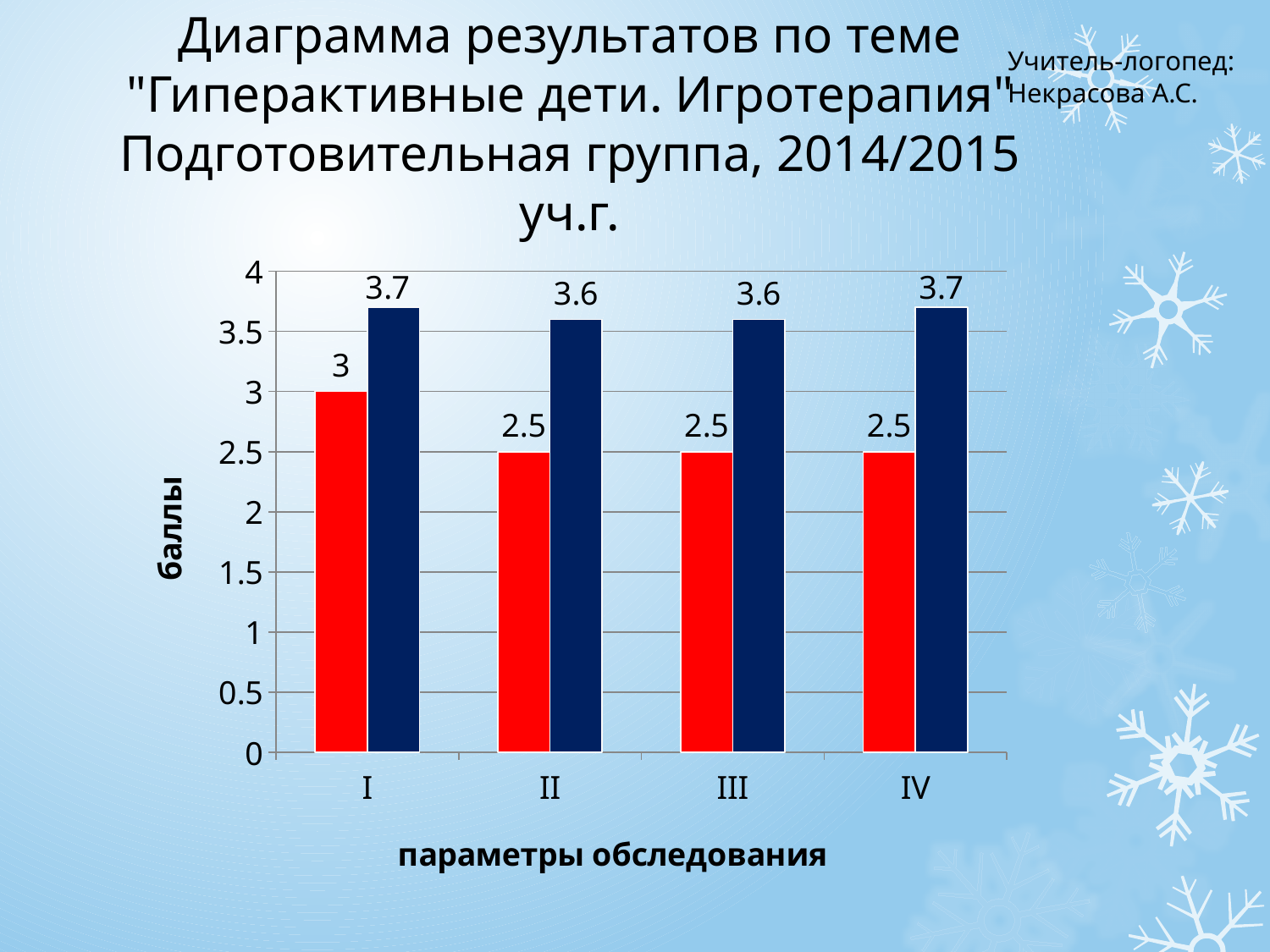
What is the difference between the dark blue bar and the red bar for category I? 0.7 What is the value of the red bar for category IV? 2.5 What is the label of the y axis of the chart? баллы Which category has the highest red bar? I What is the value of the red bar for category I? 3 What is the difference between the dark blue bar and the red bar for category III? 1.1 What is the value of the dark blue bar for category IV? 3.7 For category II, which bar is larger, the red one or the dark blue one? the dark blue one What type of chart is shown on the slide? bar chart What is the label of the x axis of the chart? параметры обследования What is the value of the dark blue bar for category II? 3.6 How many categories are shown on the x axis of the chart? 4